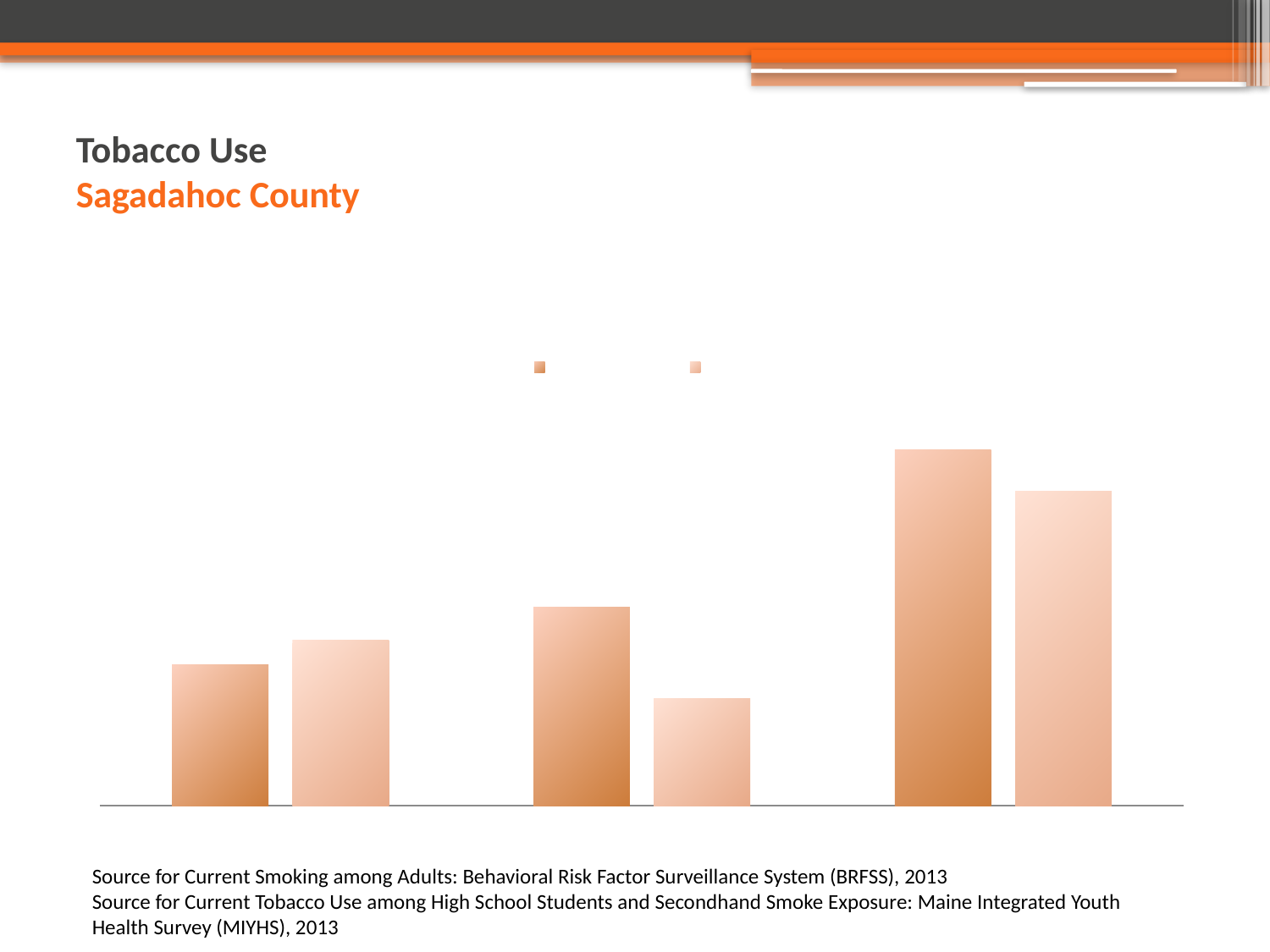
What kind of chart is shown on the slide? bar chart In the middle group of bars, is the darker orange bar or the lighter orange bar taller? the darker orange bar In the leftmost group of bars, is the darker orange bar or the lighter orange bar taller? the lighter orange bar How many bars are plotted in total on the chart? 6 Do the darker orange bars rise or fall from left to right across the three groups? rise What is the title text shown above the chart on the slide? Tobacco Use Sagadahoc County What colours are used for the two series in the chart? dark orange and light orange How many groups of bars are plotted along the x axis? 3 In the rightmost group of bars, is the darker orange bar or the lighter orange bar taller? the darker orange bar Which bar is the shortest on the chart? the lighter orange bar in the middle group Which group of bars contains the tallest bar on the chart? the rightmost group How many series does the chart's legend list? 2